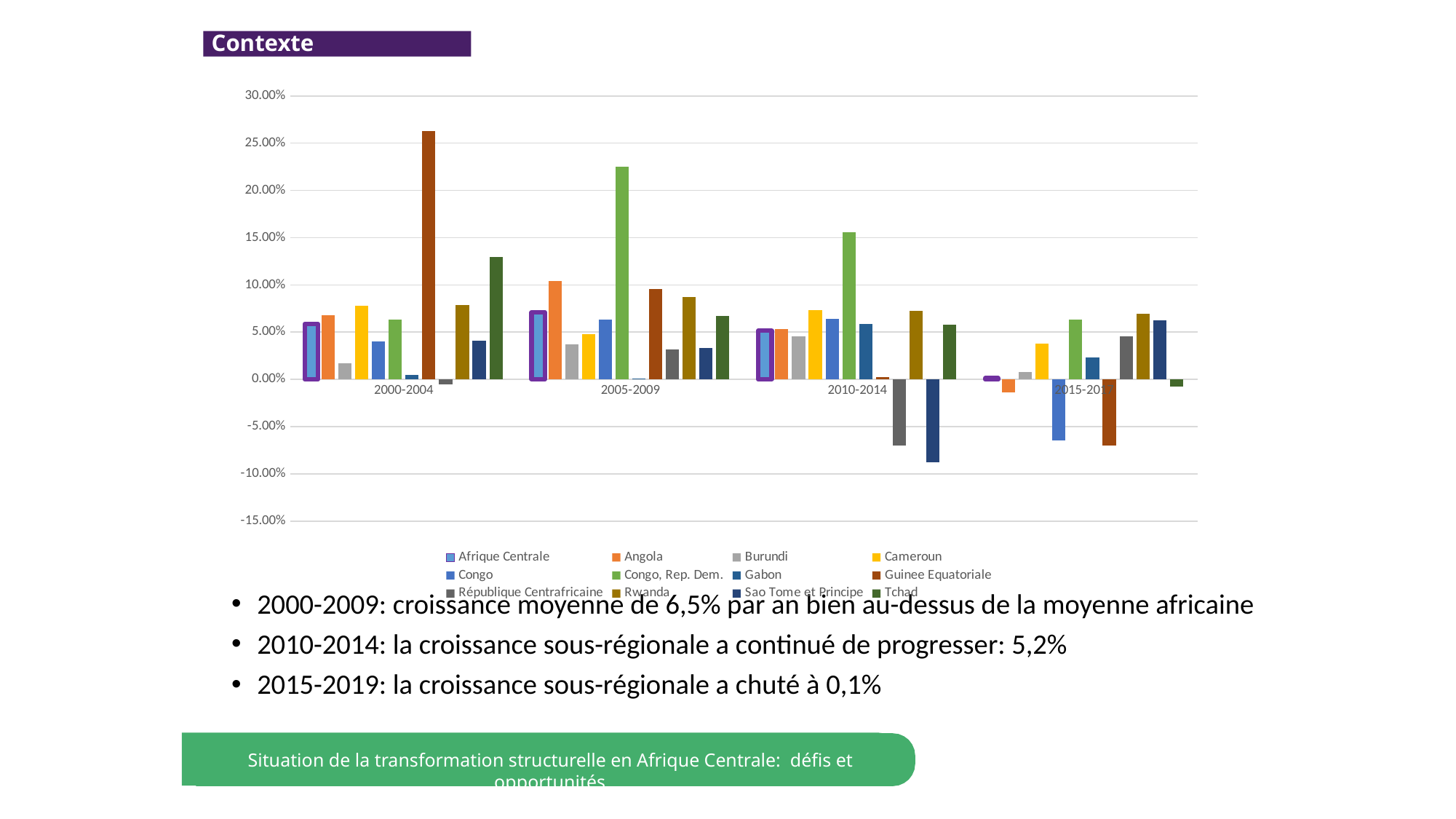
Which series has the highest value in the 2010-2014 period? Congo, Rep. Dem. What kind of chart is shown on the slide? bar chart In the 2005-2009 period, which is larger: the value for Angola or the value for Cameroun? Angola Is the value for Tchad in 2000-2004 greater or less than 10.00%? greater Is the value for Guinee Equatoriale in 2000-2004 greater or less than 25.00%? greater Is the value for Sao Tome et Principe in 2010-2014 greater or less than -5.00%? less Which series has the lowest value in the 2010-2014 period? Sao Tome et Principe Which series has the highest value in the 2000-2004 period? Guinee Equatoriale Do the values for Guinee Equatoriale rise or fall across the periods from 2000-2004 to 2015-2019? fall How many period categories are shown on the x axis of the chart? 4 Which series has the highest value in the 2005-2009 period? Congo, Rep. Dem. How many series does the chart's legend list? 12